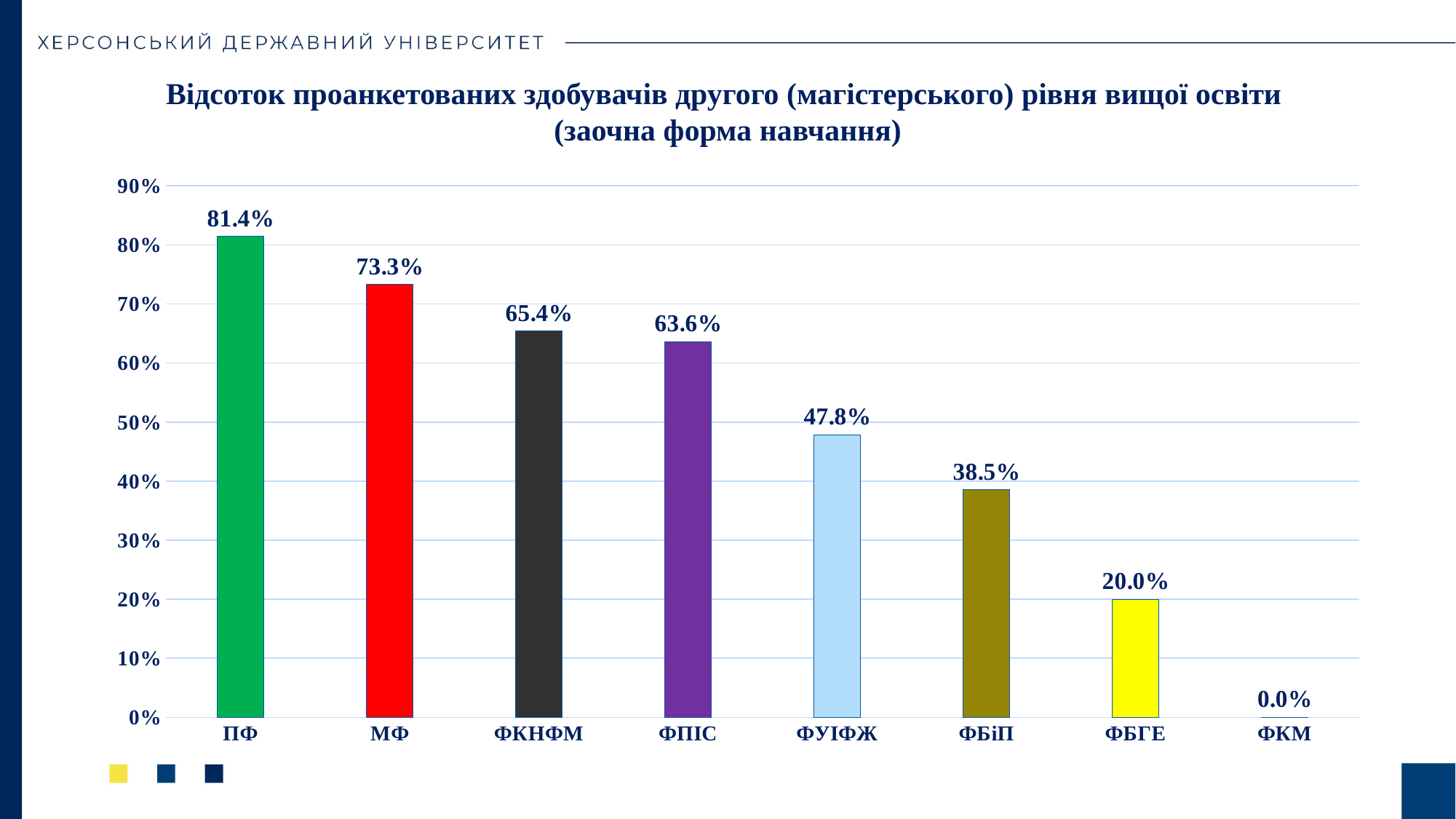
What is the difference between the values for ФБіП and ФБГЕ? 18.5% Which is larger, the value for ФКНФМ or the value for ФПІС? ФКНФМ Do the values rise or fall from left to right along the x axis? fall What is the difference between the values for ПФ and МФ? 8.1% What kind of chart is shown on the slide? bar chart Is the value for ФБіП greater or less than 40%? less What is the value for ФУІФЖ? 47.8% Which category has the highest value? ПФ How many categories are shown on the x axis? 8 What is the value for ПФ? 81.4% Which category has the lowest value? ФКМ What is the value for ФБГЕ? 20.0%